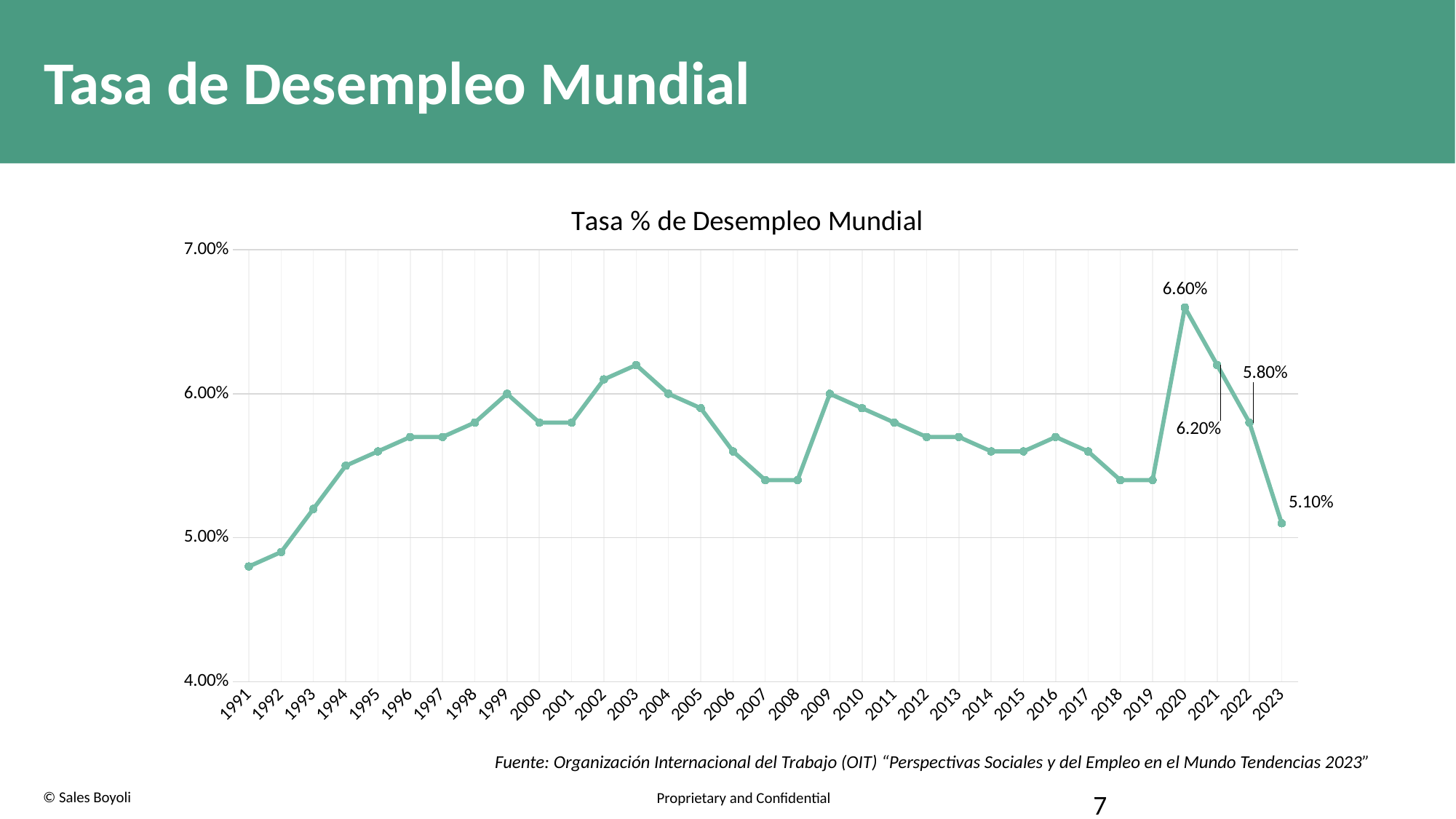
What is the value for 2021? 6.20% Which year has the highest unemployment rate? 2020 How many years are plotted on the x axis? 33 Which is larger, the value for 2020 or the value for 2022? 2020 Which year has the lowest unemployment rate? 1991 What is the value for 2022? 5.80% What is the value for 2023? 5.10% What is the difference between the values for 2020 and 2023? 1.50% What kind of chart is shown? line chart Is the value for 1991 greater or less than 5.00%? less Is the value for 2003 greater or less than 6.00%? greater What is the value for 2020? 6.60%